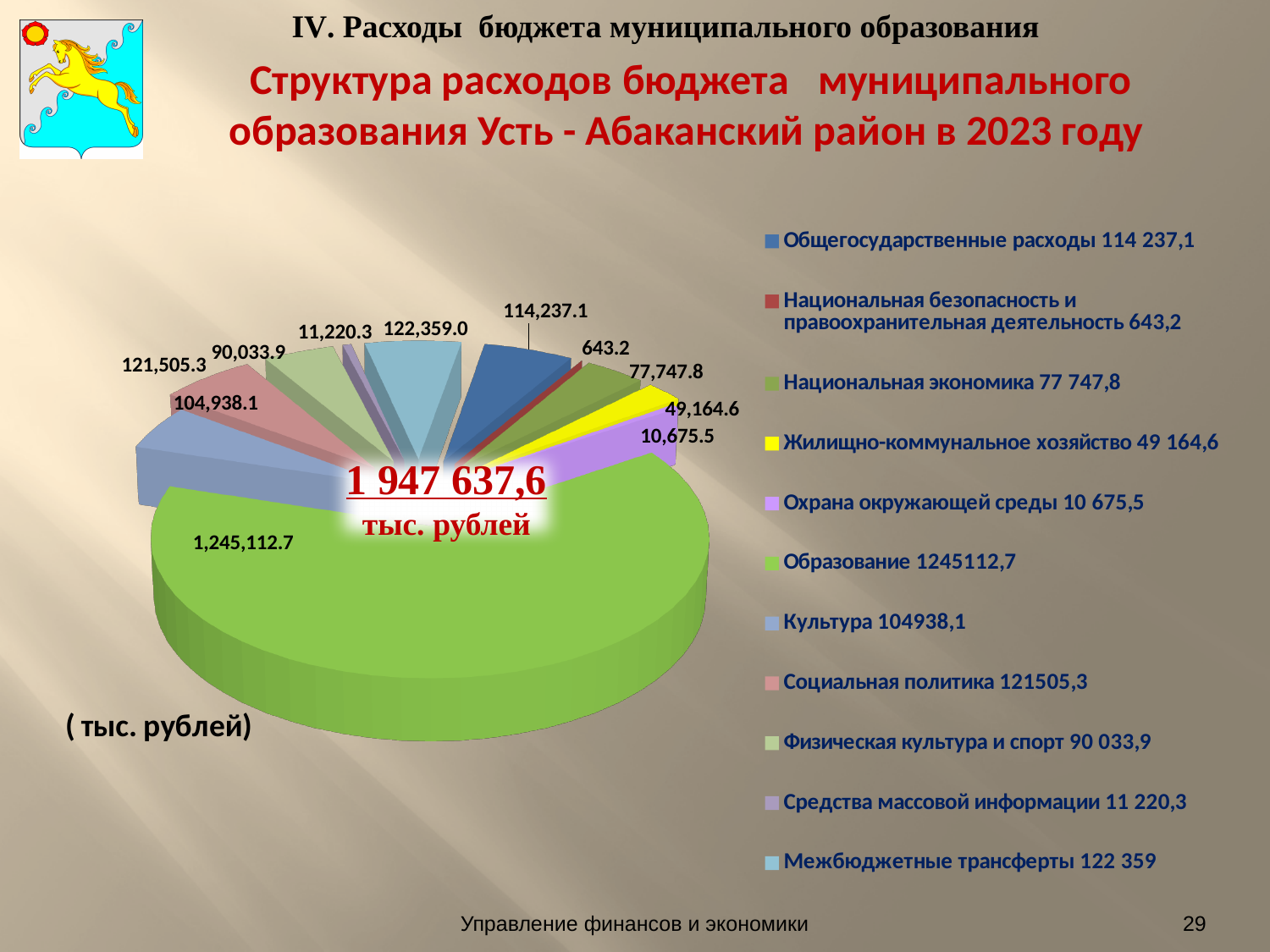
What is the value for Межбюджетные трансферты? 122,359.0 Which category has the largest slice of the pie? Образование What kind of chart is shown on the slide? Pie chart What colour is the Образование slice? Green What total is printed in the centre of the pie chart? 1 947 637,6 тыс. рублей Which is larger: Национальная экономика or Физическая культура и спорт? Физическая культура и спорт How many categories are shown in the pie chart? 11 What is the value for Образование on the pie chart? 1,245,112.7 What is the value for Национальная безопасность и правоохранительная деятельность? 643.2 Which category has the smallest slice of the pie? Национальная безопасность и правоохранительная деятельность What is the difference between the values for Общегосударственные расходы and Культура? 9,299.0 What is the value for Жилищно-коммунальное хозяйство? 49,164.6